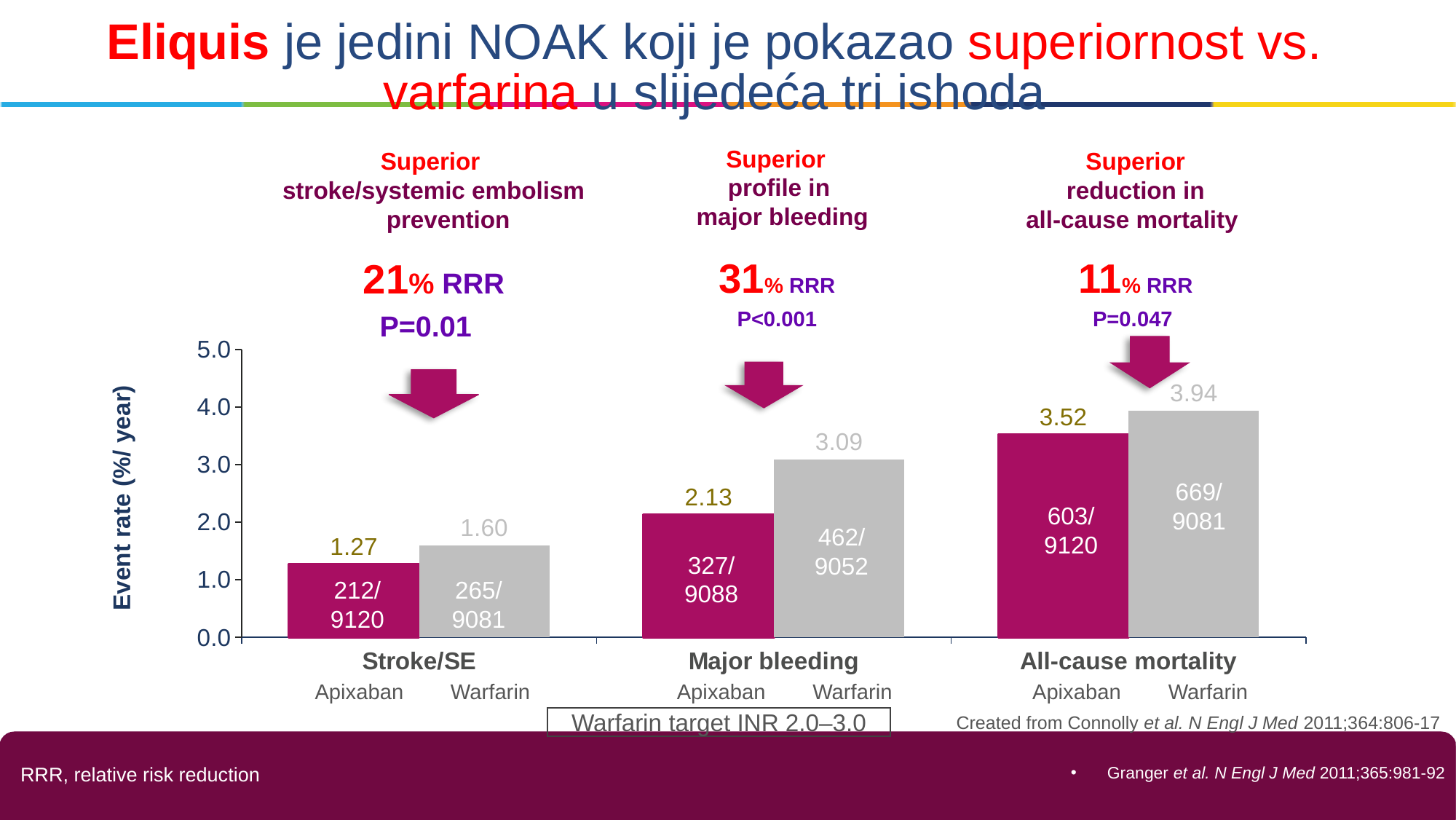
What kind of chart is shown on the slide? bar chart What is the difference between the Warfarin and Apixaban event rates in the Major bleeding category? 0.96 What is the event rate for Warfarin in the All-cause mortality category? 3.94 Is the Apixaban event rate for Major bleeding greater or less than 3.0? less What is the event rate for Warfarin in the Major bleeding category? 3.09 What is the label of the y axis of the chart? Event rate (%/ year) How many outcome categories are shown on the x axis of the chart? 3 What is the event rate for Apixaban in the All-cause mortality category? 3.52 What is the event rate for Apixaban in the Stroke/SE category? 1.27 Which bar has the lowest event rate on the chart? Apixaban, Stroke/SE Which bar has the highest event rate on the chart? Warfarin, All-cause mortality Which has a higher event rate in the Stroke/SE category, Apixaban or Warfarin? Warfarin